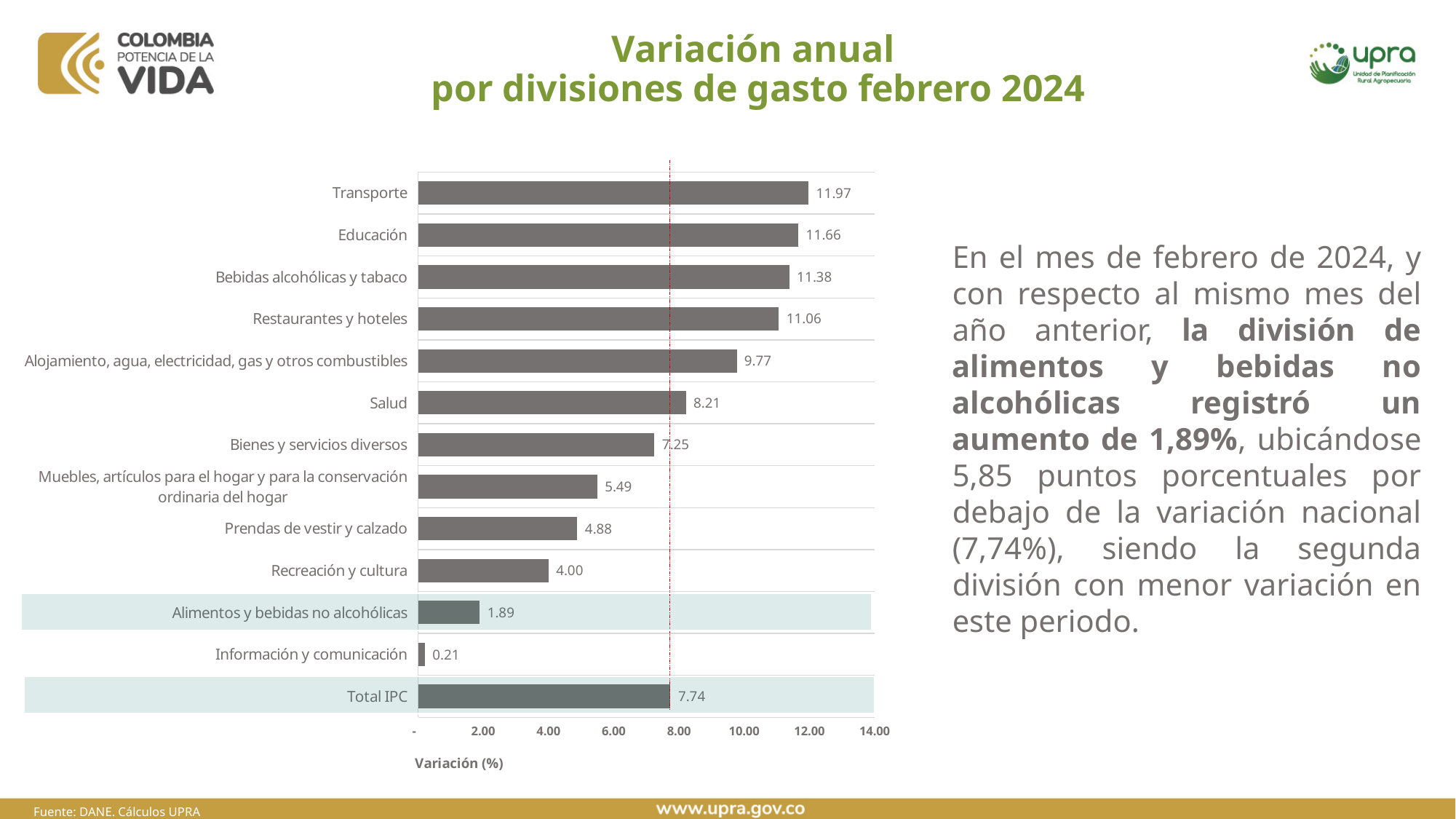
What is the difference between the values for Transporte and Educación? 0.31 How many categories are shown on the chart? 13 What is the value for Salud? 8.21 Is the value for Recreación y cultura greater or less than 6.00? less Which category has the lowest value? Información y comunicación What is the value for Total IPC? 7.74 What is the value for Alimentos y bebidas no alcohólicas? 1.89 Which is larger, the value for Salud or the value for Bienes y servicios diversos? Salud What kind of chart is shown on the slide? bar chart What is the difference between the values for Total IPC and Alimentos y bebidas no alcohólicas? 5.85 What is the value for Transporte? 11.97 Which category has the highest value? Transporte